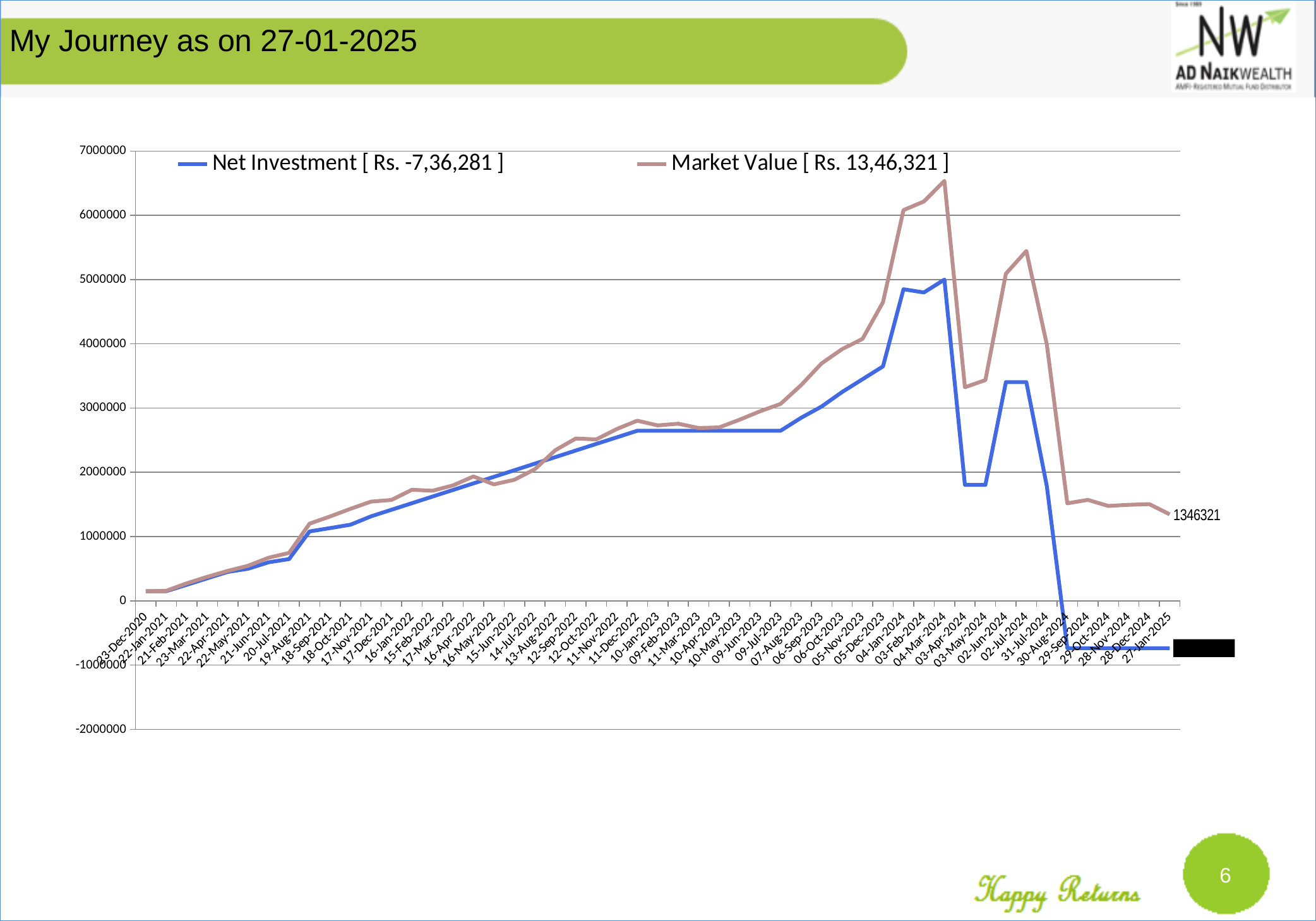
What is the Market Value on 27-Jan-2025 according to the data label? 1346321 What kind of chart is shown on the slide? line chart Is the Net Investment on 27-Jan-2025 greater or less than 0? less What is the full legend entry for the Market Value series? Market Value [ Rs. 13,46,321 ] Does the Net Investment series rise or fall from 23-Dec-2020 to 04-Mar-2024? rise What is the full legend entry for the Net Investment series? Net Investment [ Rs. -7,36,281 ] Is the Market Value on 02-Jul-2024 greater or less than 5000000? greater On which date does the Market Value series reach its highest point? 04-Mar-2024 On 04-Mar-2024, which series has the higher value, Net Investment or Market Value? Market Value How many series does the chart's legend list? 2 Is the Market Value on 04-Mar-2024 greater or less than 6000000? greater